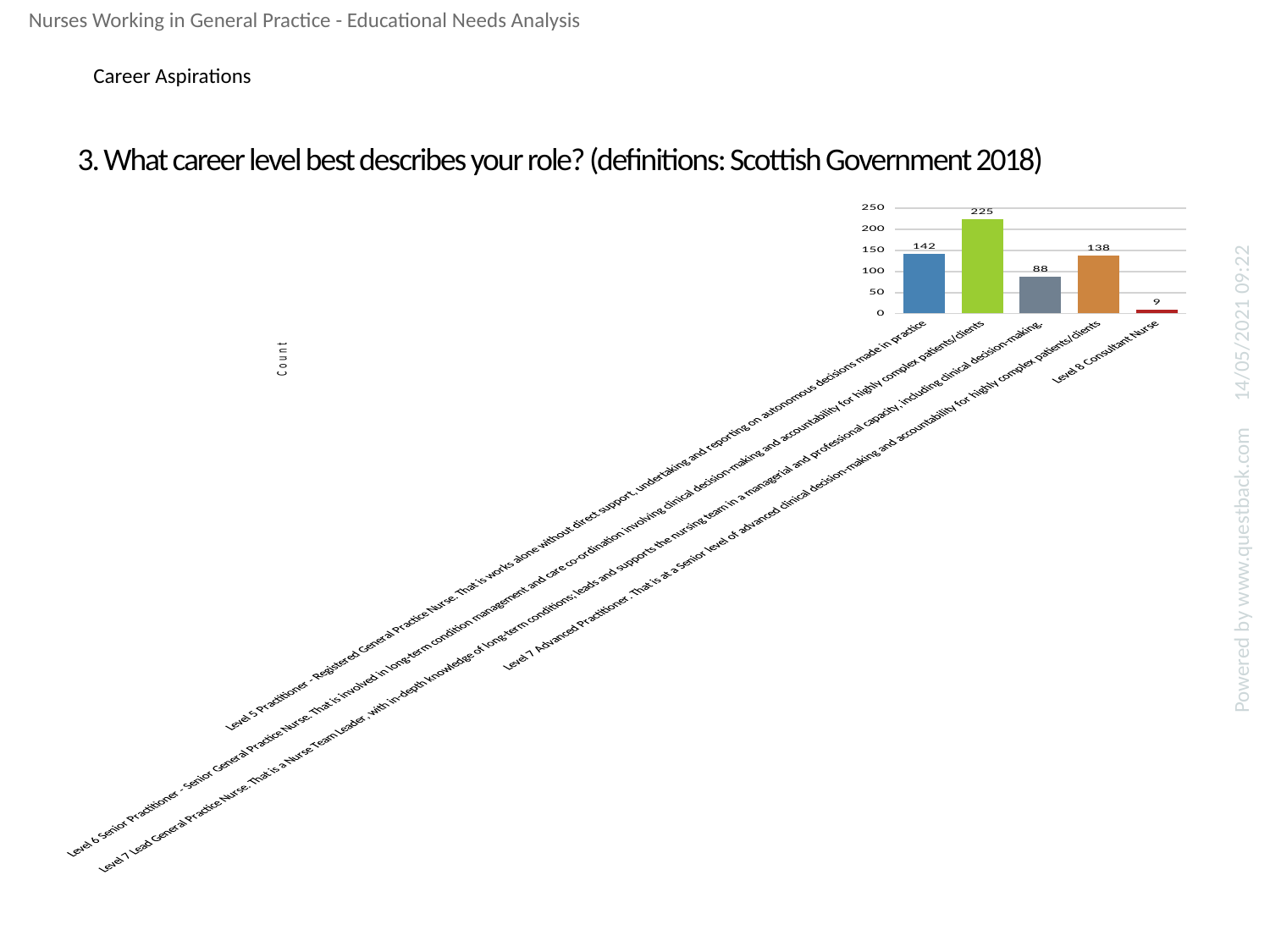
What is the count for Level 6 Senior Practitioner? 225 How many career levels are shown in the chart? 5 What kind of chart is shown on the slide? Bar chart What is the count for Level 5 Practitioner? 142 What is the count for Level 7 Lead General Practice Nurse? 88 Which has a larger count, Level 7 Lead General Practice Nurse or Level 7 Advanced Practitioner? Level 7 Advanced Practitioner Which career level has the highest count? Level 6 Senior Practitioner What is the label of the vertical axis? Count What is the count for Level 8 Consultant Nurse? 9 What is the difference between the counts for Level 6 Senior Practitioner and Level 5 Practitioner? 83 What is the count for Level 7 Advanced Practitioner? 138 Which career level has the lowest count? Level 8 Consultant Nurse